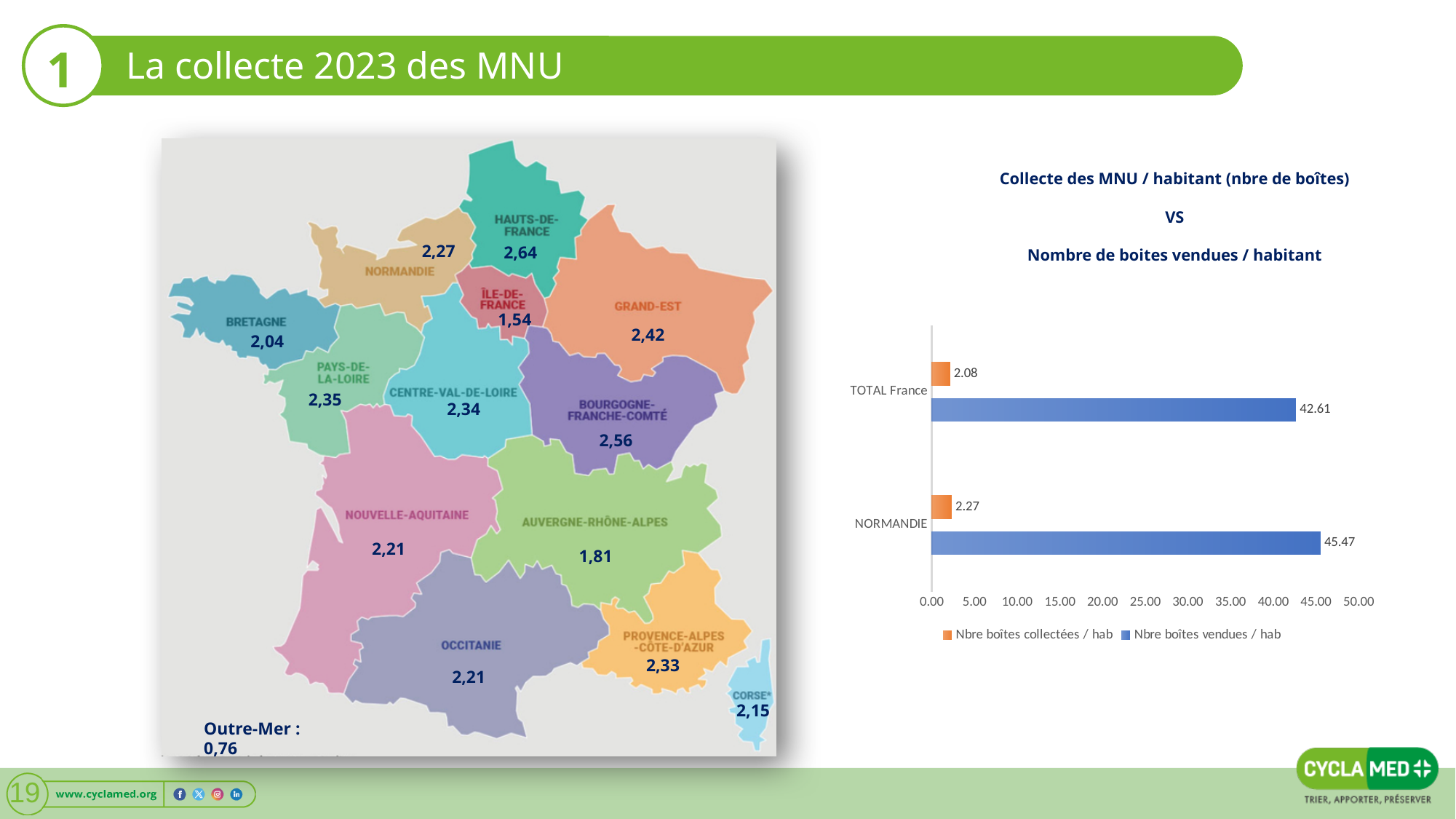
In the bar chart, what is the value of 'Nbre boîtes collectées / hab' for TOTAL France? 2.08 What kind of chart is shown on the right of the slide? Bar chart In the bar chart, what is the value of 'Nbre boîtes vendues / hab' for NORMANDIE? 45.47 In the bar chart, which category has the higher 'Nbre boîtes vendues / hab' value, TOTAL France or NORMANDIE? NORMANDIE In the bar chart, what is the value of 'Nbre boîtes collectées / hab' for NORMANDIE? 2.27 How many series does the legend of the bar chart list? 2 In the bar chart, what is the difference between the 'Nbre boîtes vendues / hab' values for NORMANDIE and TOTAL France? 2.86 In the bar chart, what is the difference between the 'Nbre boîtes collectées / hab' values for NORMANDIE and TOTAL France? 0.19 In the bar chart, is the 'Nbre boîtes vendues / hab' value for TOTAL France greater or less than 40.00? greater In the bar chart, which colour represents the 'Nbre boîtes collectées / hab' series? Orange How many categories are shown on the bar chart? 2 In the bar chart, what is the value of 'Nbre boîtes vendues / hab' for TOTAL France? 42.61